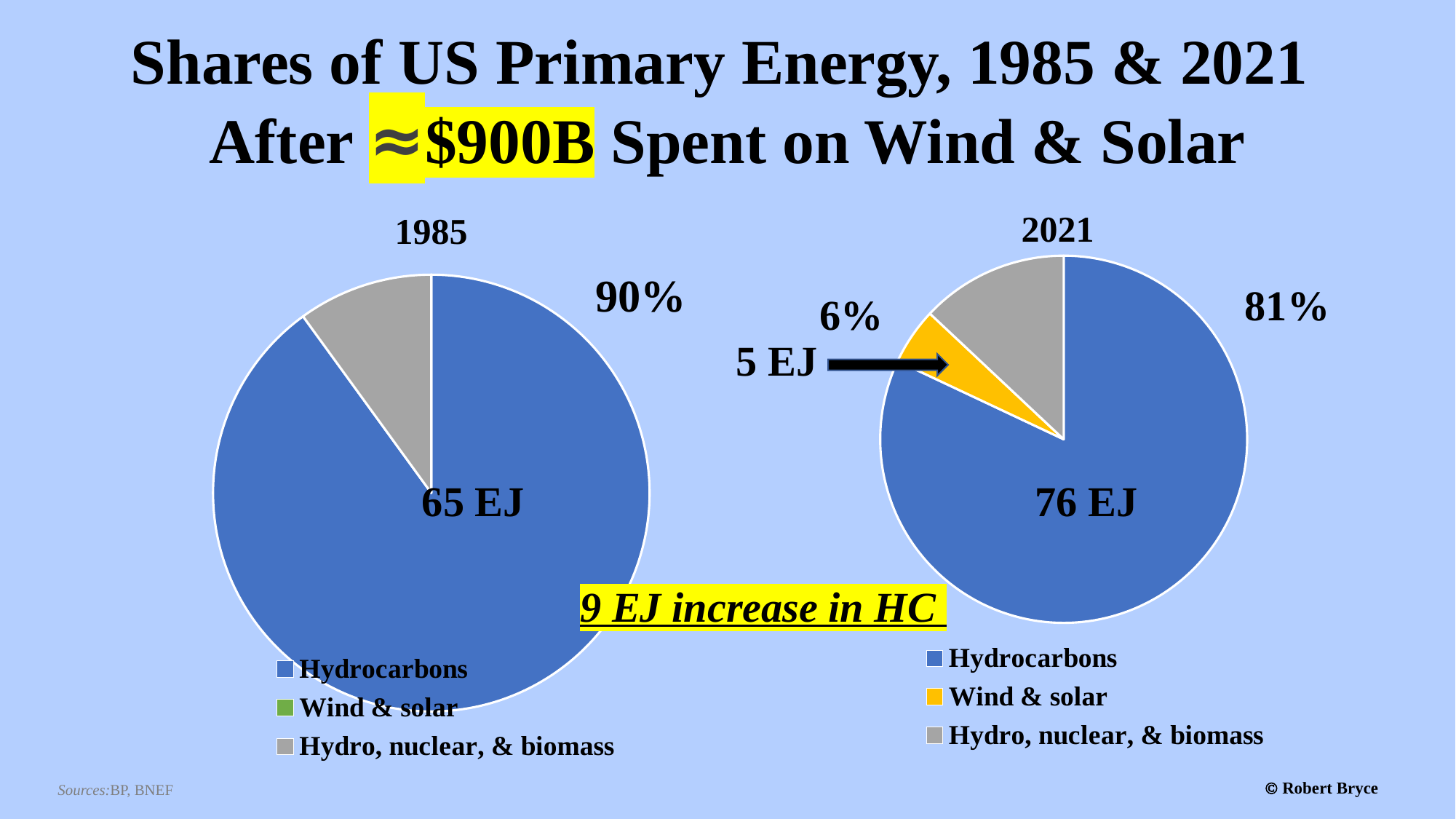
In the 2021 pie chart, what share is labelled for wind & solar? 6% In the 2021 pie chart, what value in EJ is labelled for wind & solar? 5 EJ Which is larger: the hydrocarbons share in 1985 or the hydrocarbons share in 2021? 1985 In the 2021 pie chart, what colour is the wind & solar slice? Orange In the 2021 pie chart, what share of US primary energy is labelled for hydrocarbons? 81% How many entries does the legend of the 2021 pie chart list? 3 What kind of charts are shown on the slide? Pie charts In the 2021 pie chart, what value in EJ is labelled for hydrocarbons? 76 EJ In the 2021 pie chart, which category is the smallest slice? Wind & solar In the 1985 pie chart, what value in EJ is labelled for hydrocarbons? 65 EJ In the 1985 pie chart, what share of US primary energy is labelled for hydrocarbons? 90%